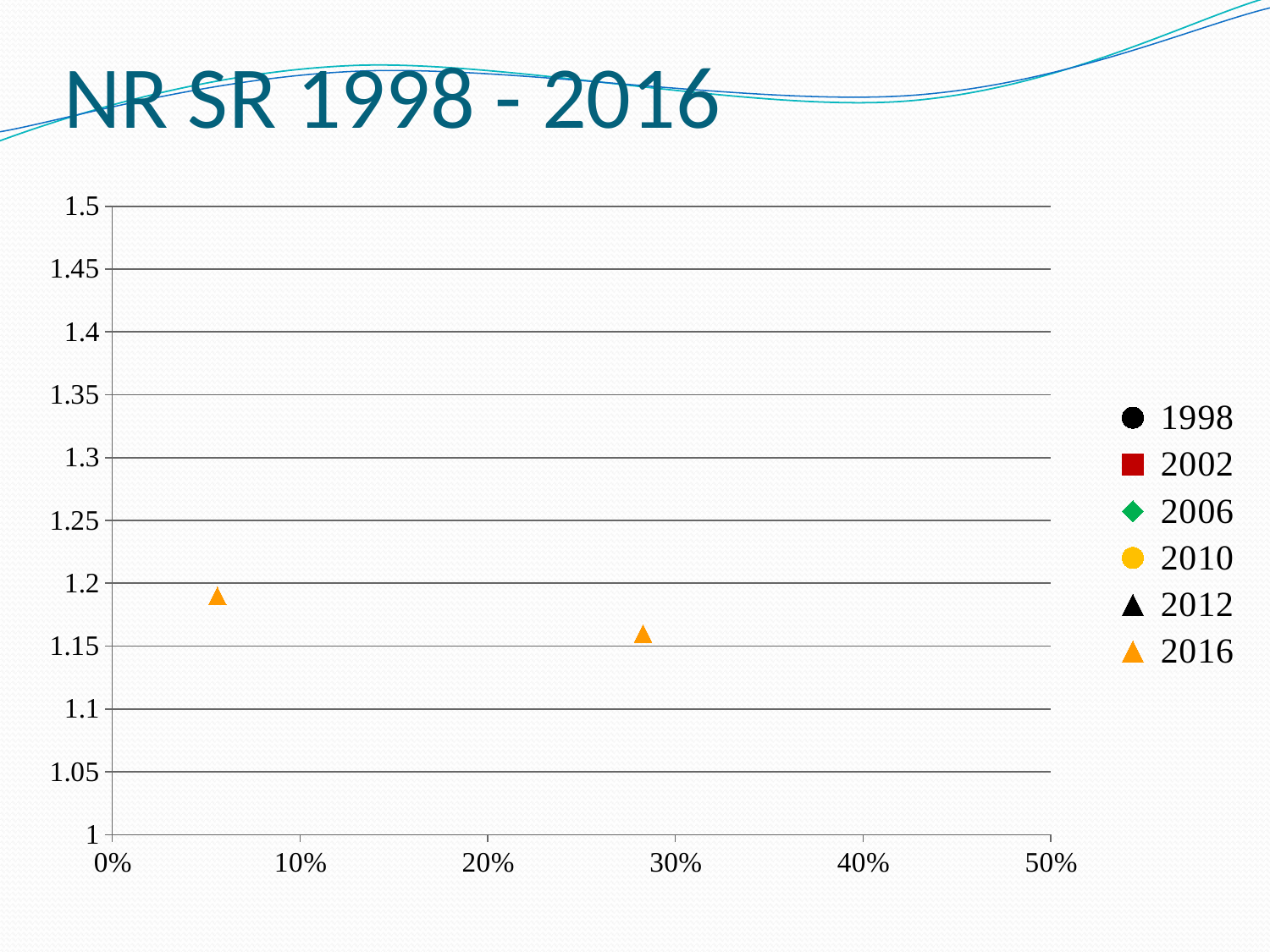
What is the title of the chart? NR SR 1998 - 2016 Which series do the plotted points belong to? 2016 Is the vertical value of the rightmost 2016 point greater or less than 1.2? less Do the plotted values rise or fall as the horizontal percentage increases? fall How many series does the legend list? 6 Which of the two 2016 points has the higher vertical value, the one near 6% or the one near 28%? the one near 6% Is the vertical value of the leftmost 2016 point greater or less than 1.15? greater How many data points are plotted on the chart? 2 What kind of chart is shown on the slide? scatter chart Is the horizontal value of the rightmost 2016 point greater or less than 30%? less